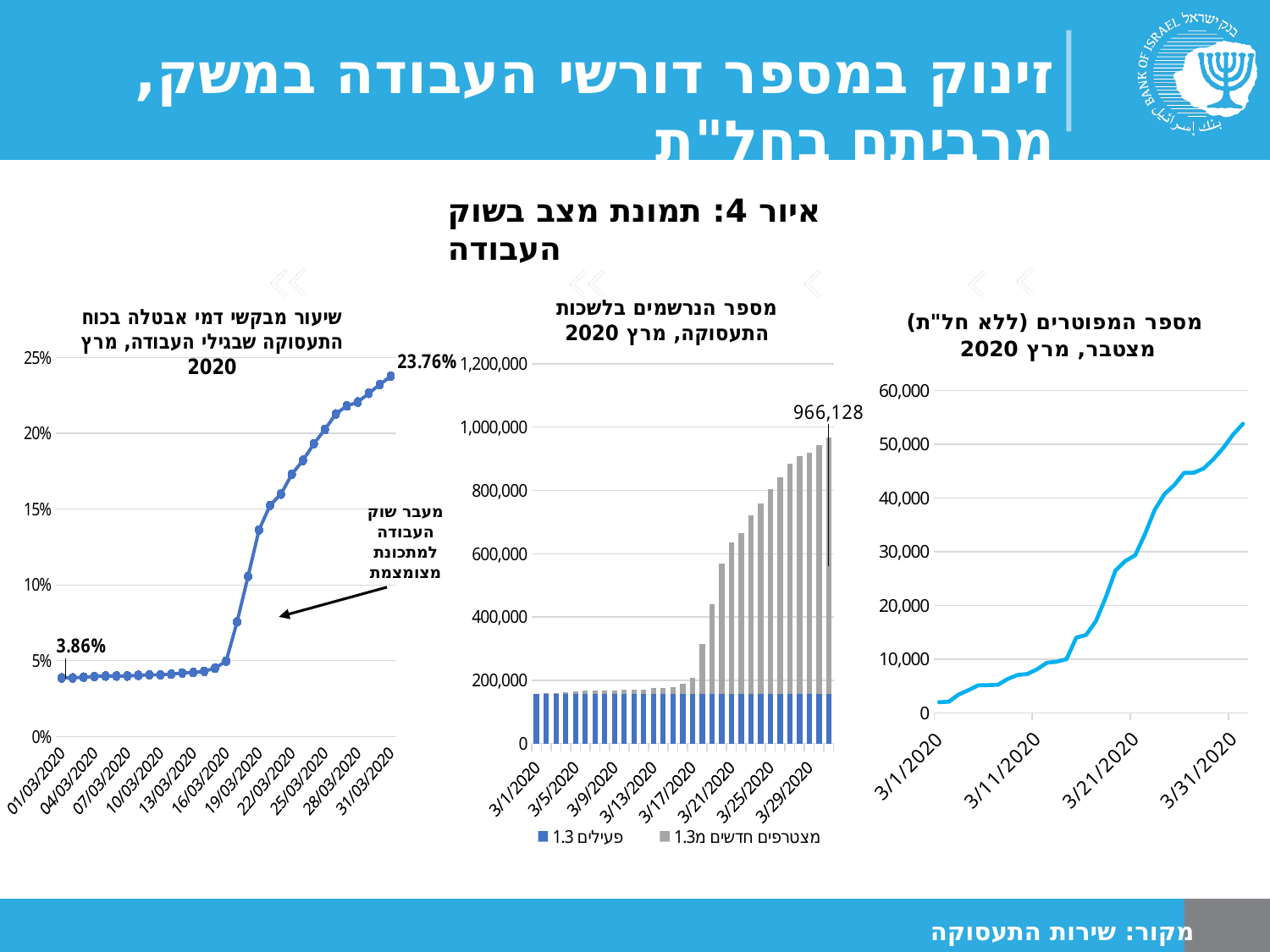
In the middle chart (number registered at employment bureaus), what total value is labelled on the last bar? 966,128 In the middle chart (number registered at employment bureaus), which legend entry is shown in blue? פעילים 1.3 What kind of chart is the left chart, 'שיעור מבקשי דמי אבטלה בכוח התעסוקה שבגילי העבודה, מרץ 2020'? line chart In the left chart (share of unemployment benefit applicants), what is the difference between the labelled end value (23.76%) and the labelled start value (3.86%)? 19.90% In the left chart (share of unemployment benefit applicants), what value is labelled at the end of the series on 31/03/2020? 23.76% What kind of chart is the middle chart, 'מספר הנרשמים בלשכות התעסוקה, מרץ 2020'? bar chart In the right chart (number of dismissed, cumulative, March 2020), do the values rise or fall over the month? rise In the right chart (number of dismissed, cumulative, March 2020), is the value on 3/31/2020 greater or less than 50,000? greater How many series does the legend of the middle chart (number registered at employment bureaus) list? 2 In the middle chart (number registered at employment bureaus), is the total for 3/29/2020 greater or less than 800,000? greater In the left chart (share of unemployment benefit applicants), what value is labelled at the start of the series on 01/03/2020? 3.86% In the left chart (share of unemployment benefit applicants), is the value on 25/03/2020 greater or less than 15%? greater